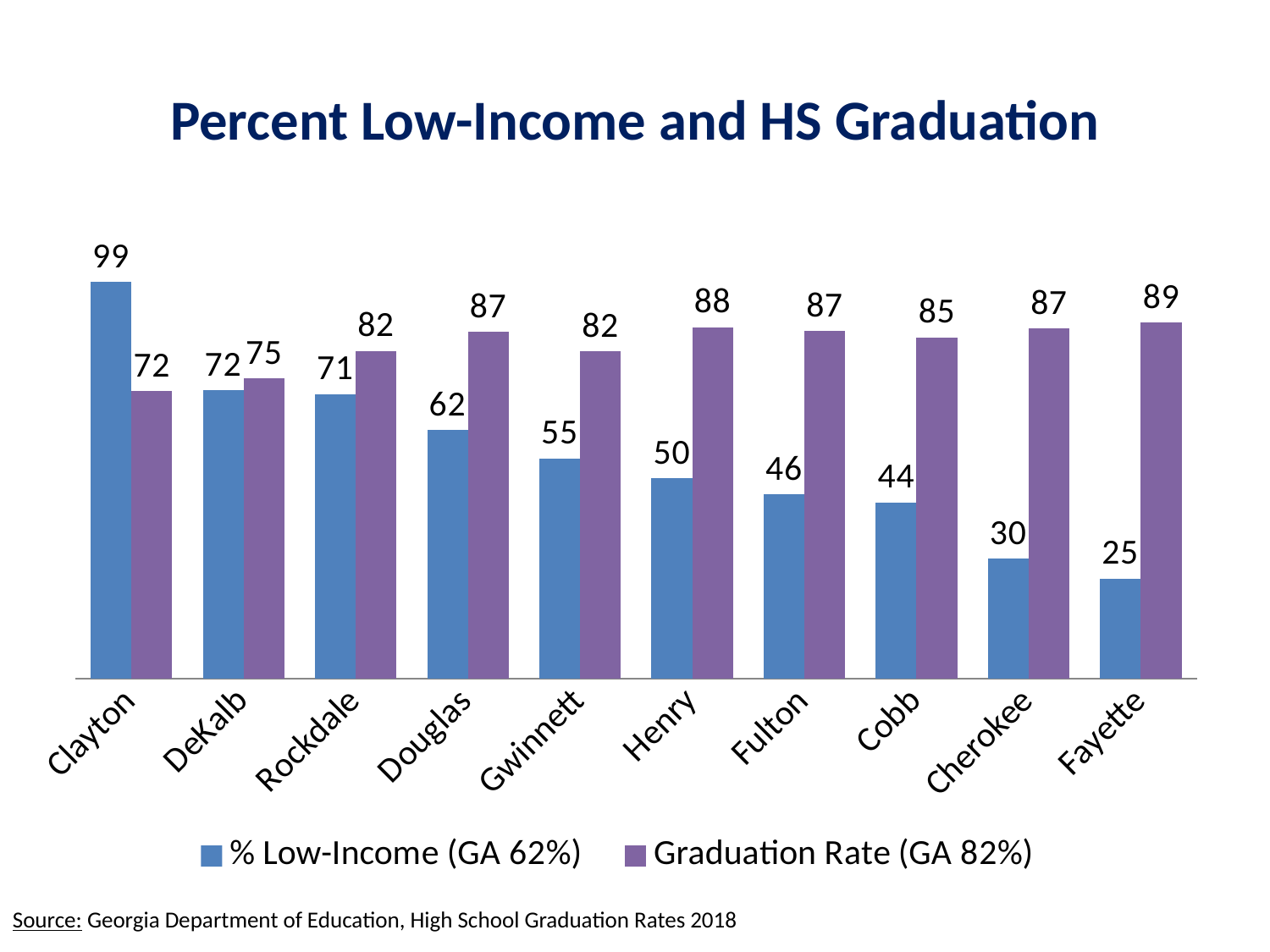
What is the % Low-Income value for Cherokee? 30 How many series does the legend list? 2 How many counties are shown on the x axis? 10 What is the difference between the Graduation Rate and the % Low-Income value for Fayette? 64 What kind of chart is shown on the slide? Bar chart Which county has the highest % Low-Income value? Clayton What is the Graduation Rate for Fayette? 89 Does the % Low-Income value rise or fall moving from Clayton to Fayette along the x axis? Fall Which is larger for Clayton: the % Low-Income value or the Graduation Rate? % Low-Income What is the % Low-Income value for Clayton? 99 Which county has the lowest Graduation Rate? Clayton Which county has the lowest % Low-Income value? Fayette